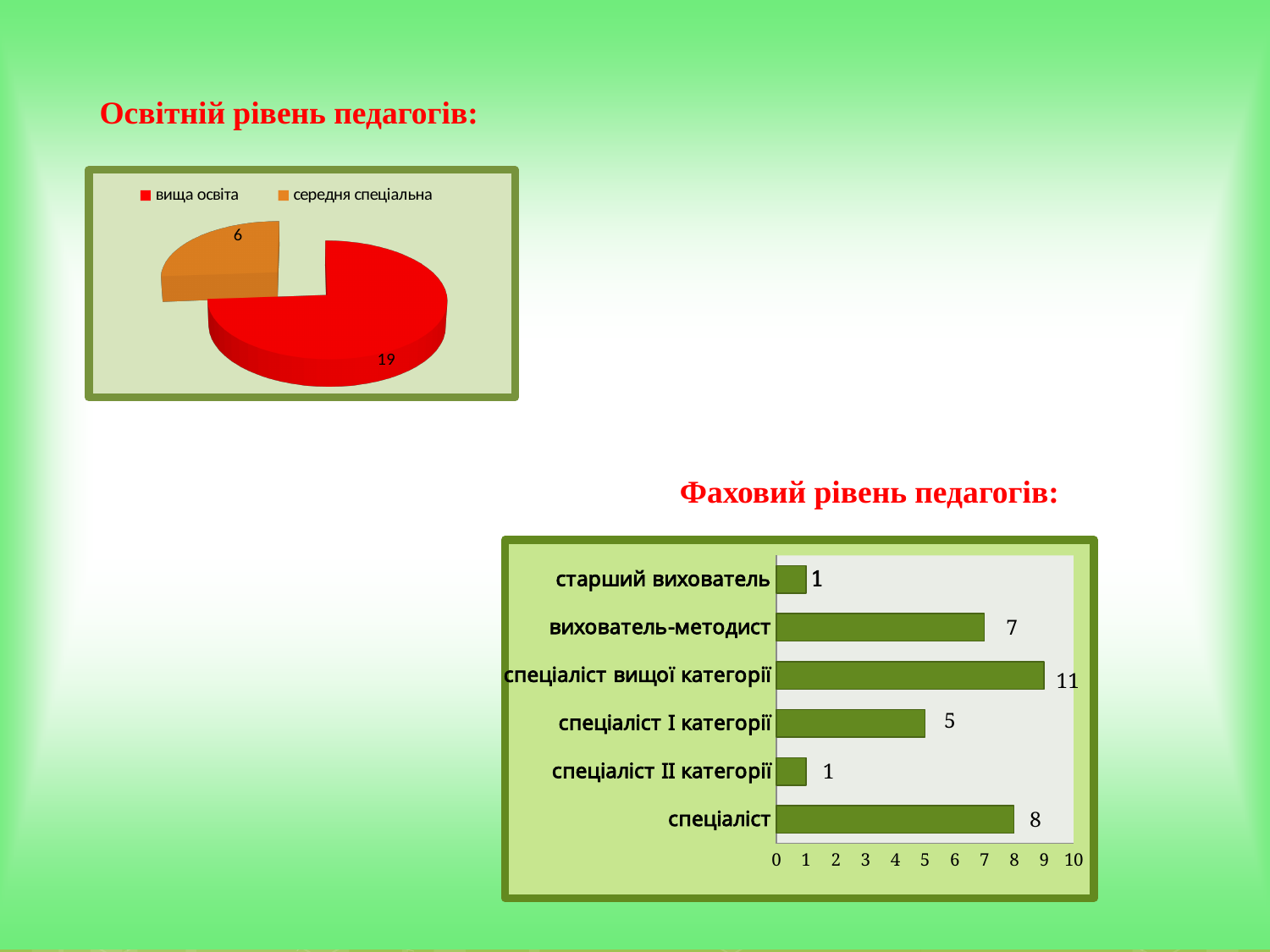
In the chart titled "Фаховий рівень педагогів:", which category has the highest value? спеціаліст вищої категорії In the pie chart titled "Освітній рівень педагогів:", what is the value for "середня спеціальна"? 6 In the chart titled "Фаховий рівень педагогів:", what is the value for "спеціаліст вищої категорії"? 11 In the chart titled "Фаховий рівень педагогів:", what is the value for "вихователь-методист"? 7 In the chart titled "Фаховий рівень педагогів:", what is the difference between the values for "спеціаліст" and "спеціаліст I категорії"? 3 In the pie chart titled "Освітній рівень педагогів:", how many entries does the legend list? 2 In the chart titled "Фаховий рівень педагогів:", how many categories are shown? 6 In the pie chart titled "Освітній рівень педагогів:", what is the difference between the values for "вища освіта" and "середня спеціальна"? 13 What kind of chart is the one titled "Фаховий рівень педагогів:"? bar chart In the pie chart titled "Освітній рівень педагогів:", what is the value for "вища освіта"? 19 In the chart titled "Фаховий рівень педагогів:", which is larger: the value for "вихователь-методист" or the value for "спеціаліст"? спеціаліст